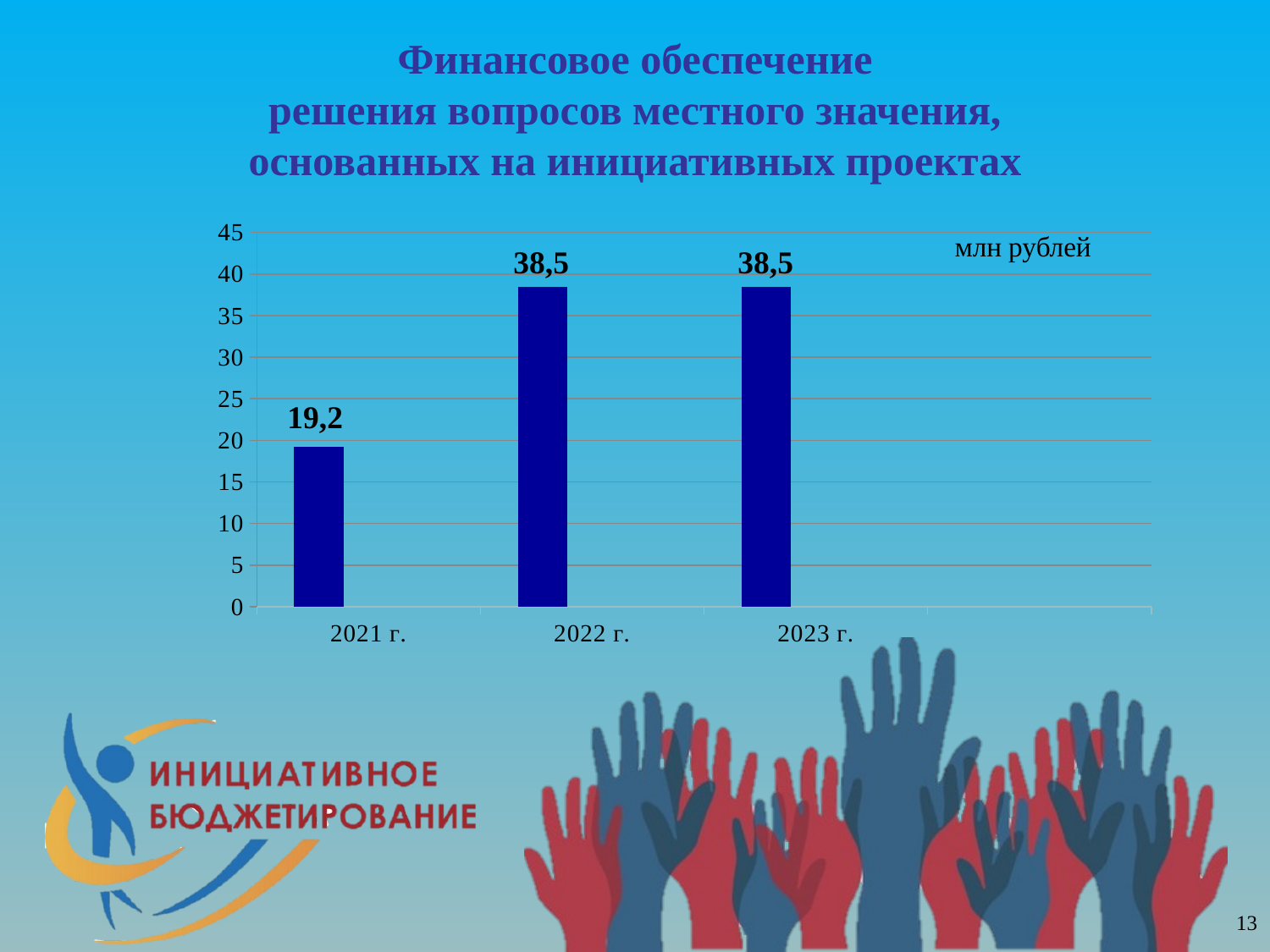
What is the value for 2022 г.? 38,5 Which year has the lowest value? 2021 г. Is the value for 2022 г. greater or less than 35? greater What kind of chart is shown on the slide? bar chart Is the value for 2021 г. greater or less than 20? less What is the value for 2023 г.? 38,5 What is the value for 2021 г.? 19,2 How many years are shown on the x axis? 3 What is the difference between the values for 2022 г. and 2021 г.? 19,3 What unit is indicated in the top right corner of the chart? млн рублей Do the values rise or fall from 2021 г. to 2022 г.? rise Which is larger, the value for 2021 г. or the value for 2023 г.? 2023 г.